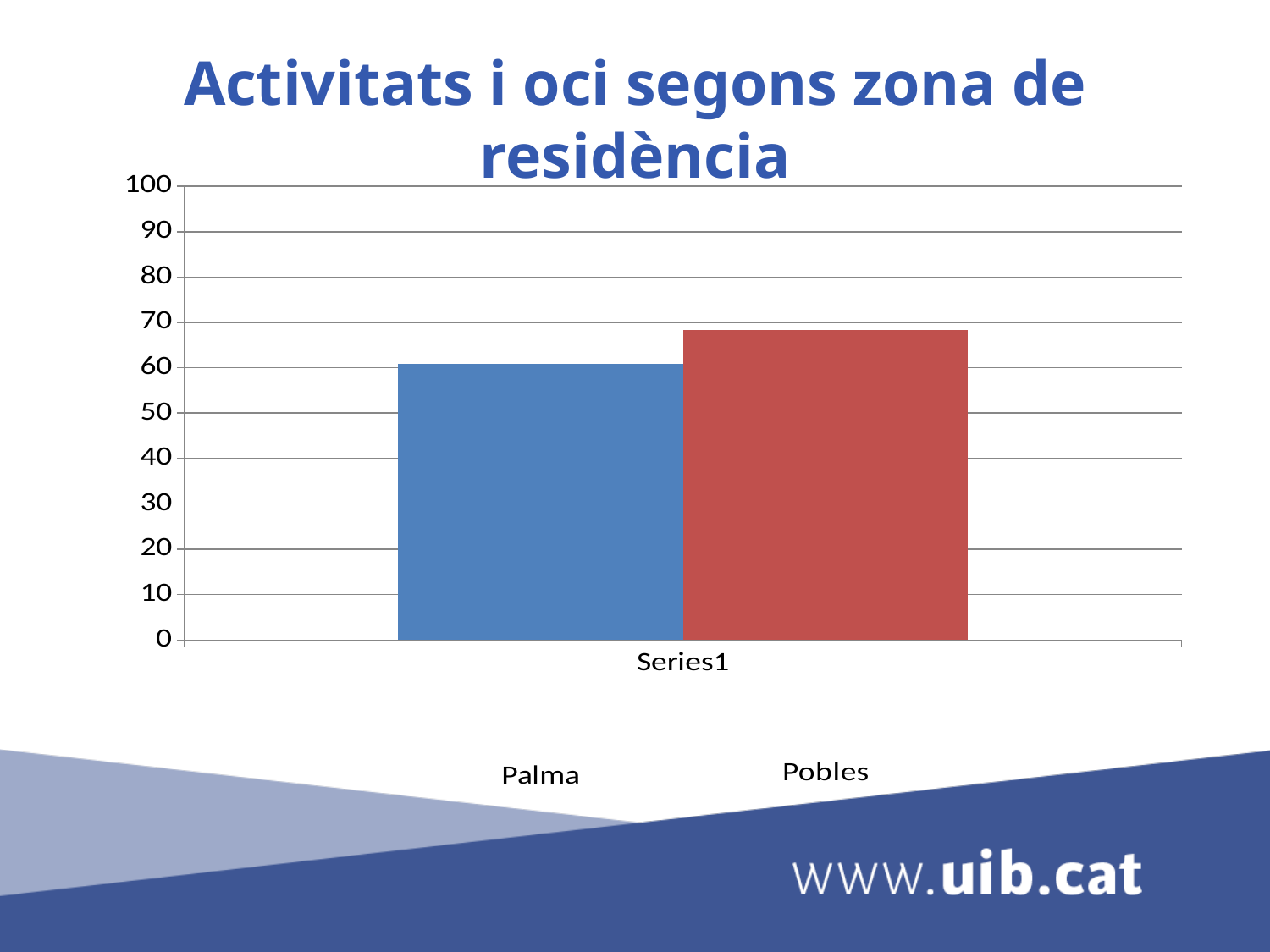
What colour is the bar for Pobles? red Is the value for Palma greater or less than 50? greater Which series has the highest value? Pobles Is the value for Pobles greater or less than 60? greater What is the title of the chart? Activitats i oci segons zona de residència Is the value for Palma greater or less than 70? less Which series has the taller bar, Palma or Pobles? Pobles Which series has the lowest value? Palma How many series does the legend list? 2 What is the maximum value shown on the vertical axis? 100 What kind of chart is shown on the slide? bar chart